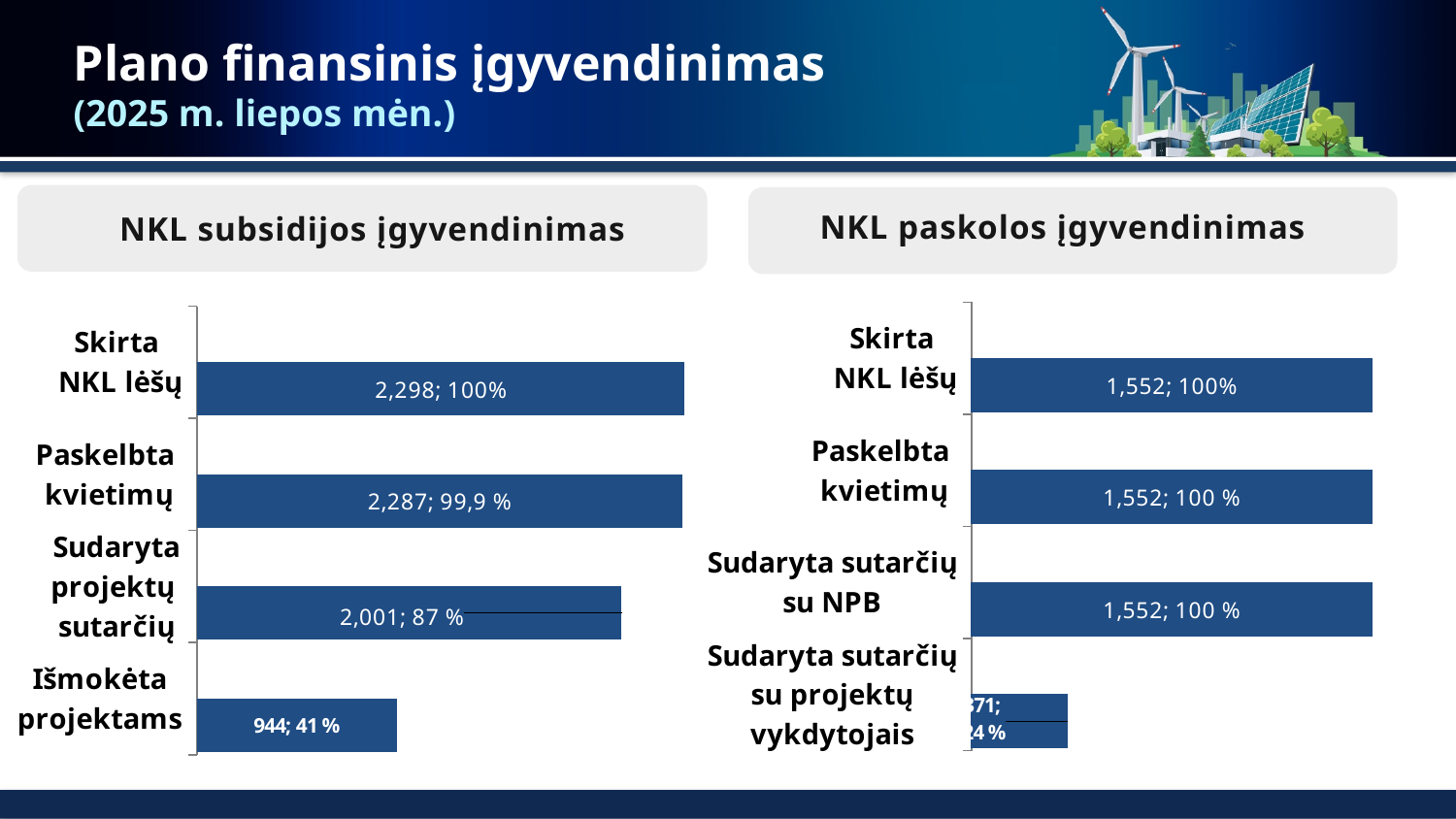
In the 'NKL subsidijos įgyvendinimas' chart, which is larger: 'Sudaryta projektų sutarčių' or 'Išmokėta projektams'? Sudaryta projektų sutarčių In the 'NKL subsidijos įgyvendinimas' chart, which category has the highest value? Skirta NKL lėšų In the 'NKL subsidijos įgyvendinimas' chart, what is the data label for 'Išmokėta projektams'? 944; 41 % In the 'NKL paskolos įgyvendinimas' chart, what is the data label for 'Sudaryta sutarčių su NPB'? 1,552; 100 % In the 'NKL subsidijos įgyvendinimas' chart, what is the data label for 'Skirta NKL lėšų'? 2,298; 100% In the 'NKL paskolos įgyvendinimas' chart, which category has the lowest value? Sudaryta sutarčių su projektų vykdytojais What type of chart is the 'NKL paskolos įgyvendinimas' chart? Bar chart In the 'NKL paskolos įgyvendinimas' chart, what is the data label for 'Skirta NKL lėšų'? 1,552; 100% In the 'NKL subsidijos įgyvendinimas' chart, what is the data label for 'Sudaryta projektų sutarčių'? 2,001; 87 % How many categories does the 'NKL subsidijos įgyvendinimas' chart show? 4 In the 'NKL subsidijos įgyvendinimas' chart, what is the difference between the values for 'Skirta NKL lėšų' and 'Paskelbta kvietimų'? 11 In the 'NKL subsidijos įgyvendinimas' chart, which category has the lowest value? Išmokėta projektams